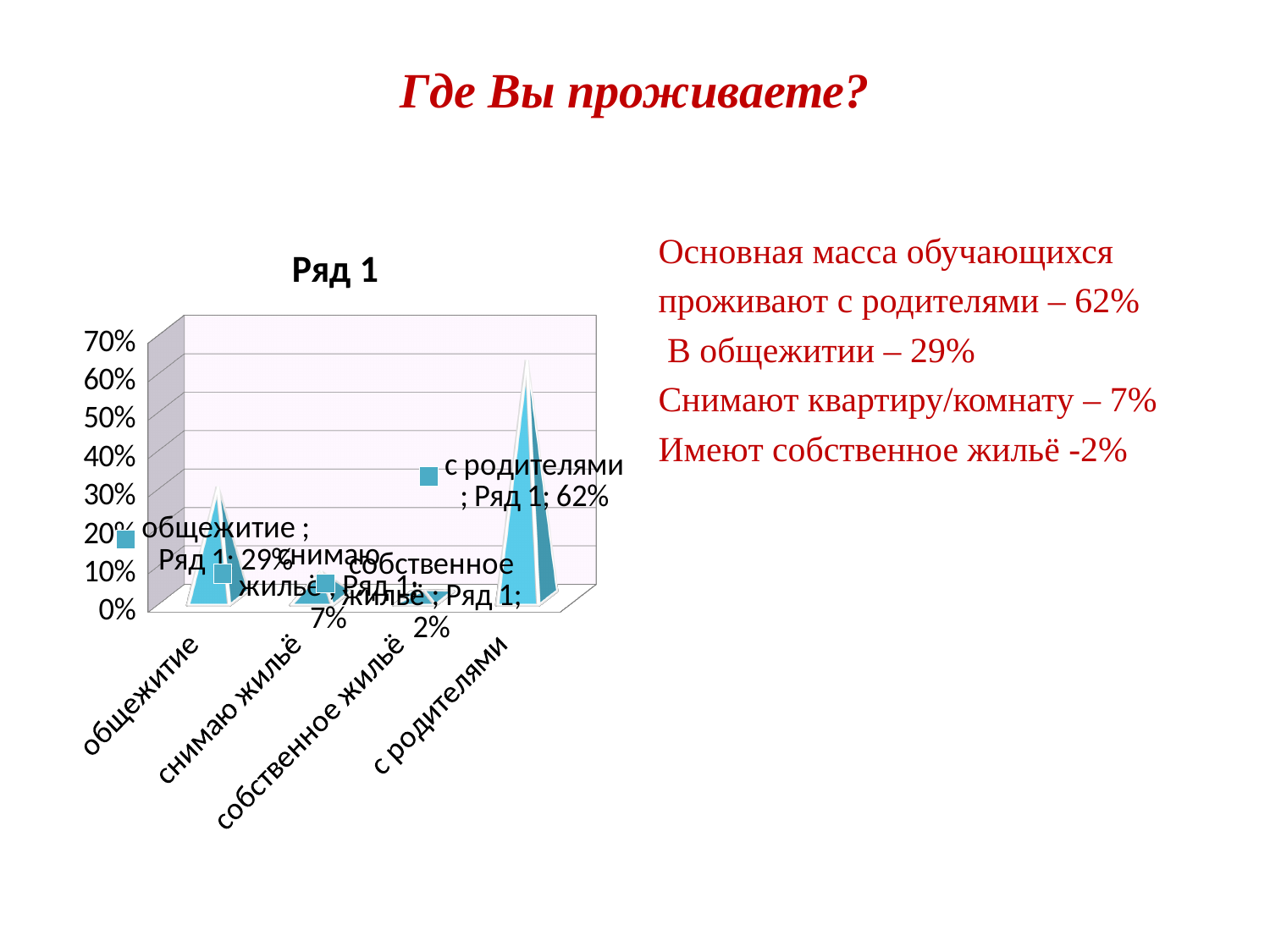
Which category has the lowest value? собственное жильё What is the difference between the values for с родителями and общежитие? 33% Is the value for с родителями greater or less than 50%? greater Which is larger, the value for общежитие or the value for снимаю жильё? общежитие How many categories are shown on the x axis? 4 What is the title of the chart? Ряд 1 What is the value for с родителями? 62% What type of chart is shown on the slide? bar chart What is the value for общежитие? 29% What is the value for снимаю жильё? 7% Which category has the highest value? с родителями What is the value for собственное жильё? 2%